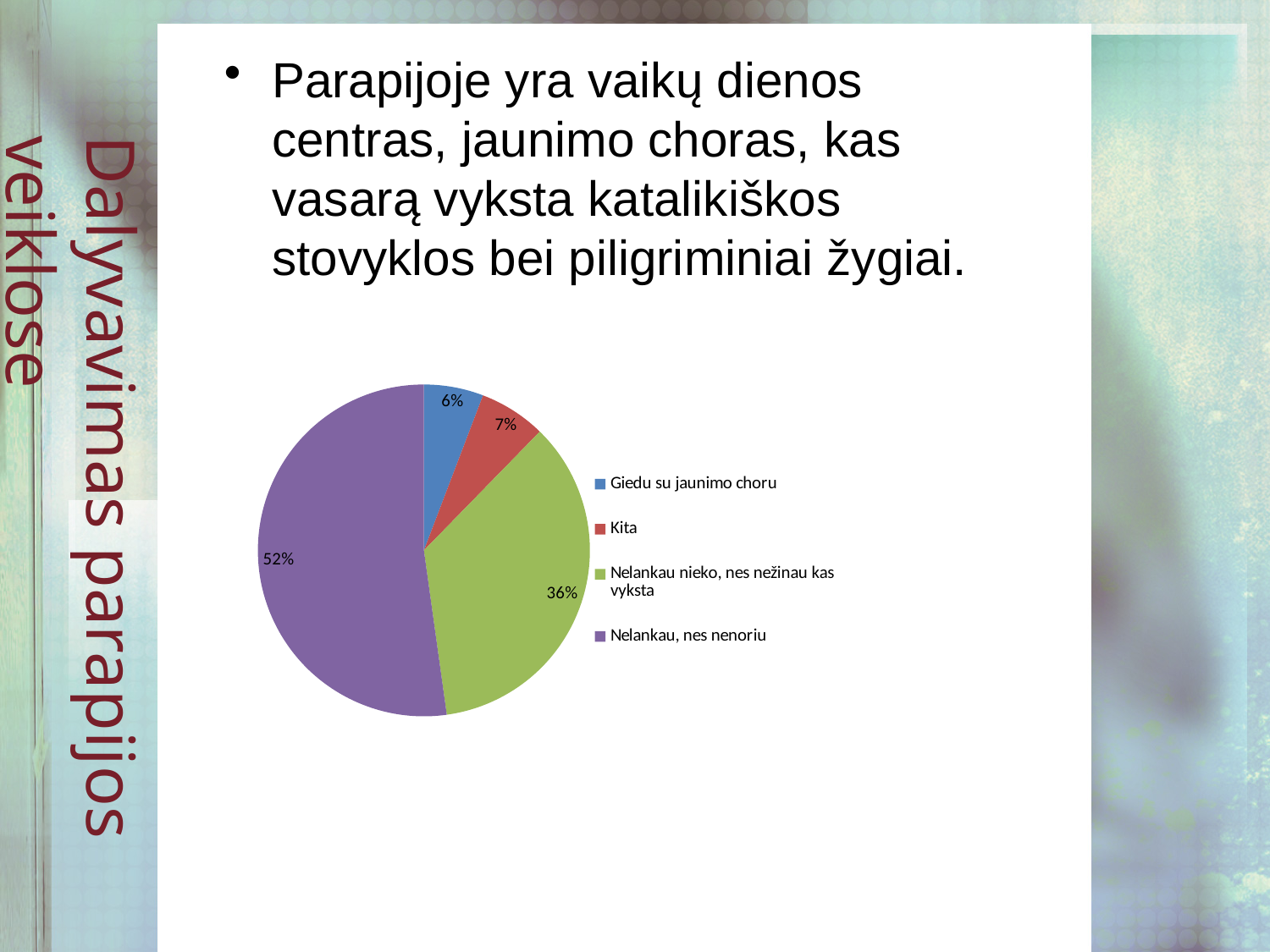
What percentage of the pie chart is labelled "Kita"? 7% Which is larger in the pie chart: "Kita" or "Giedu su jaunimo choru"? Kita Which category has the largest slice of the pie chart? Nelankau, nes nenoriu What percentage of the pie chart is labelled "Nelankau nieko, nes nežinau kas vyksta"? 36% What is the difference in percentage points between "Nelankau, nes nenoriu" and "Nelankau nieko, nes nežinau kas vyksta"? 16 What colour is the slice for "Nelankau, nes nenoriu" in the pie chart? purple How many slices does the pie chart have? 4 What percentage of the pie chart is labelled "Giedu su jaunimo choru"? 6% What kind of chart is shown on the slide? pie chart What percentage of the pie chart is labelled "Nelankau, nes nenoriu"? 52% Which category has the smallest slice of the pie chart? Giedu su jaunimo choru What is the combined percentage of the two "Nelankau" categories in the pie chart? 88%